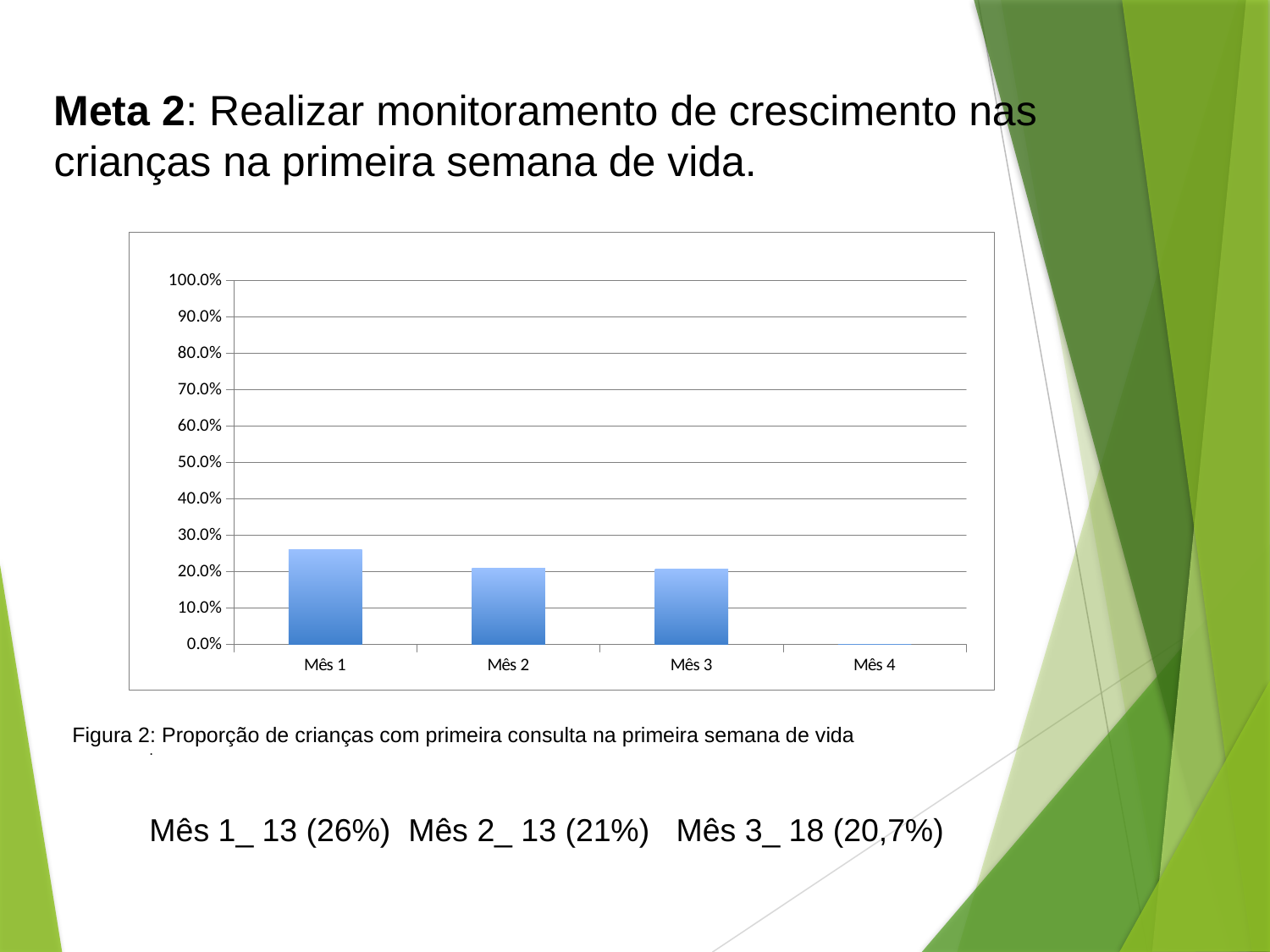
Is the value for Mês 2 greater or less than 30.0%? less What is the value for Mês 2? 21% Which month has the highest bar? Mês 1 What is the value for Mês 3? 20,7% What is the difference between the values for Mês 1 and Mês 2? 5% Do the bar values rise or fall from Mês 1 to Mês 3? Fall How many month categories are shown on the x axis? 4 What is the value for Mês 1? 26% What kind of chart is shown on the slide? Bar chart Is the value for Mês 1 greater or less than 20.0%? greater What is the highest value shown on the y axis? 100.0% Which is larger, the value for Mês 1 or the value for Mês 3? Mês 1